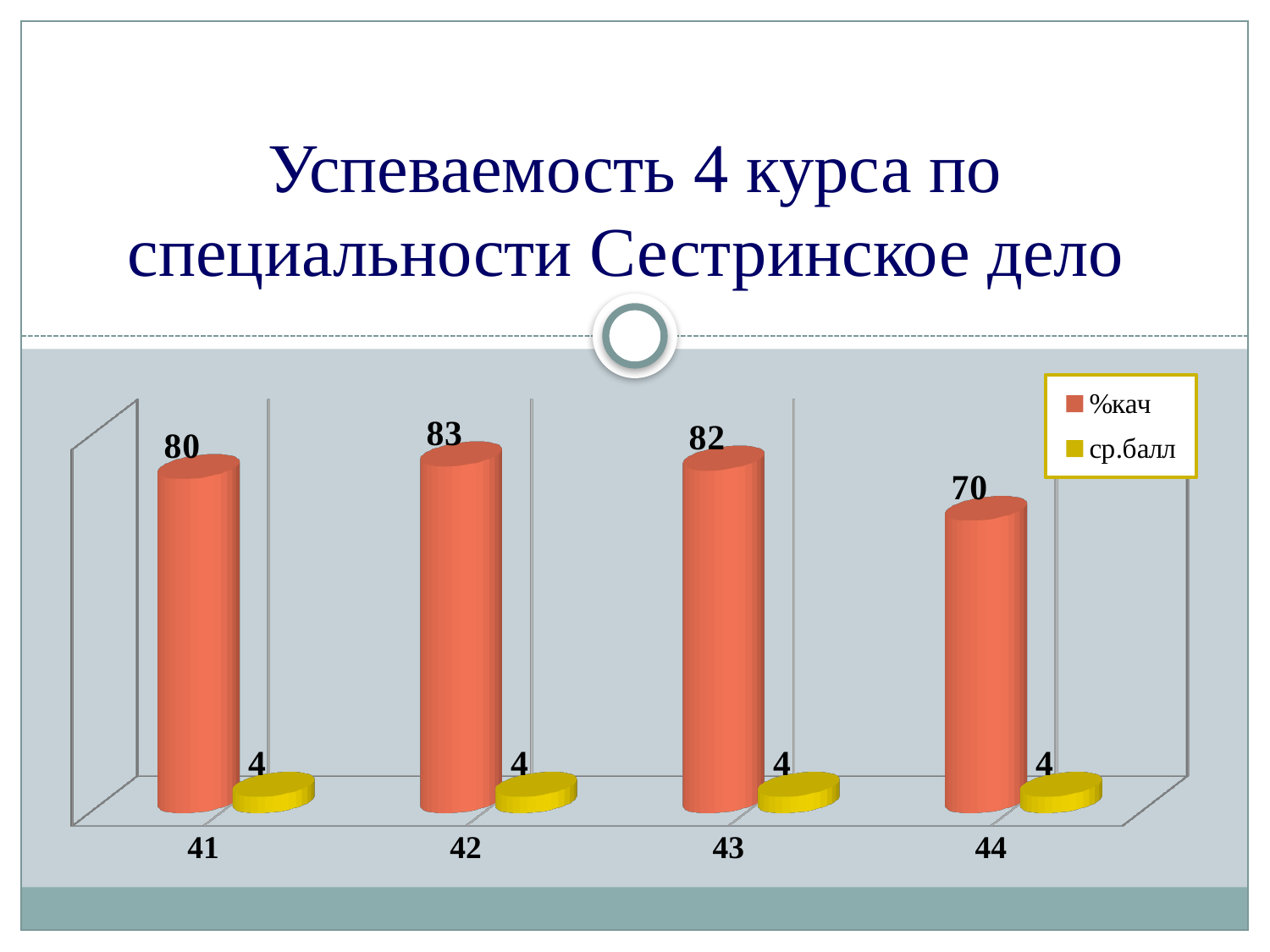
Which colour represents the ср.балл series? yellow What is the difference between the %кач values for groups 43 and 44? 12 What is the %кач value for group 44? 70 How many series does the legend list? 2 Which group has a larger %кач value, 41 or 43? 43 Does the %кач value rise or fall from group 43 to group 44? fall Which group has the lowest %кач value? 44 What is the %кач value for group 42? 83 How many groups are shown on the x axis? 4 Which group has the highest %кач value? 42 What kind of chart is shown on the slide? bar chart What is the ср.балл value for group 41? 4